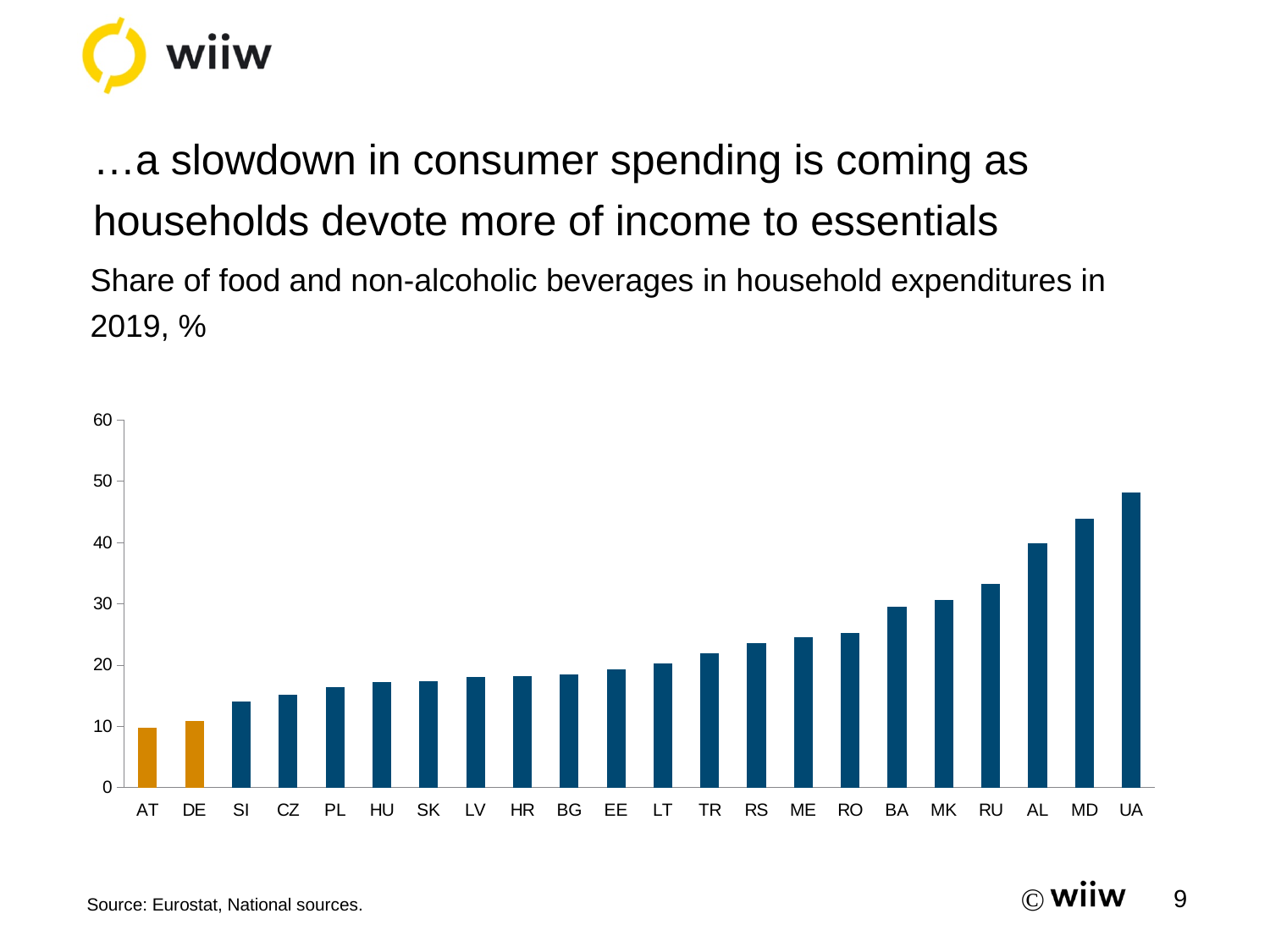
What kind of chart is shown on the slide? bar chart Which has a larger value, MD or UA? UA Is the value for UA greater or less than 40? greater Is the value for RU greater or less than 30? greater Which country has the lowest share of food and non-alcoholic beverages in household expenditures? AT Which two countries' bars are coloured orange rather than blue? AT and DE Which has a larger value, RU or RO? RU Is the value for RO greater or less than 30? less Do the values rise or fall moving from left to right along the x axis? rise How many countries are shown on the x axis of the chart? 22 Which country has the highest share of food and non-alcoholic beverages in household expenditures? UA